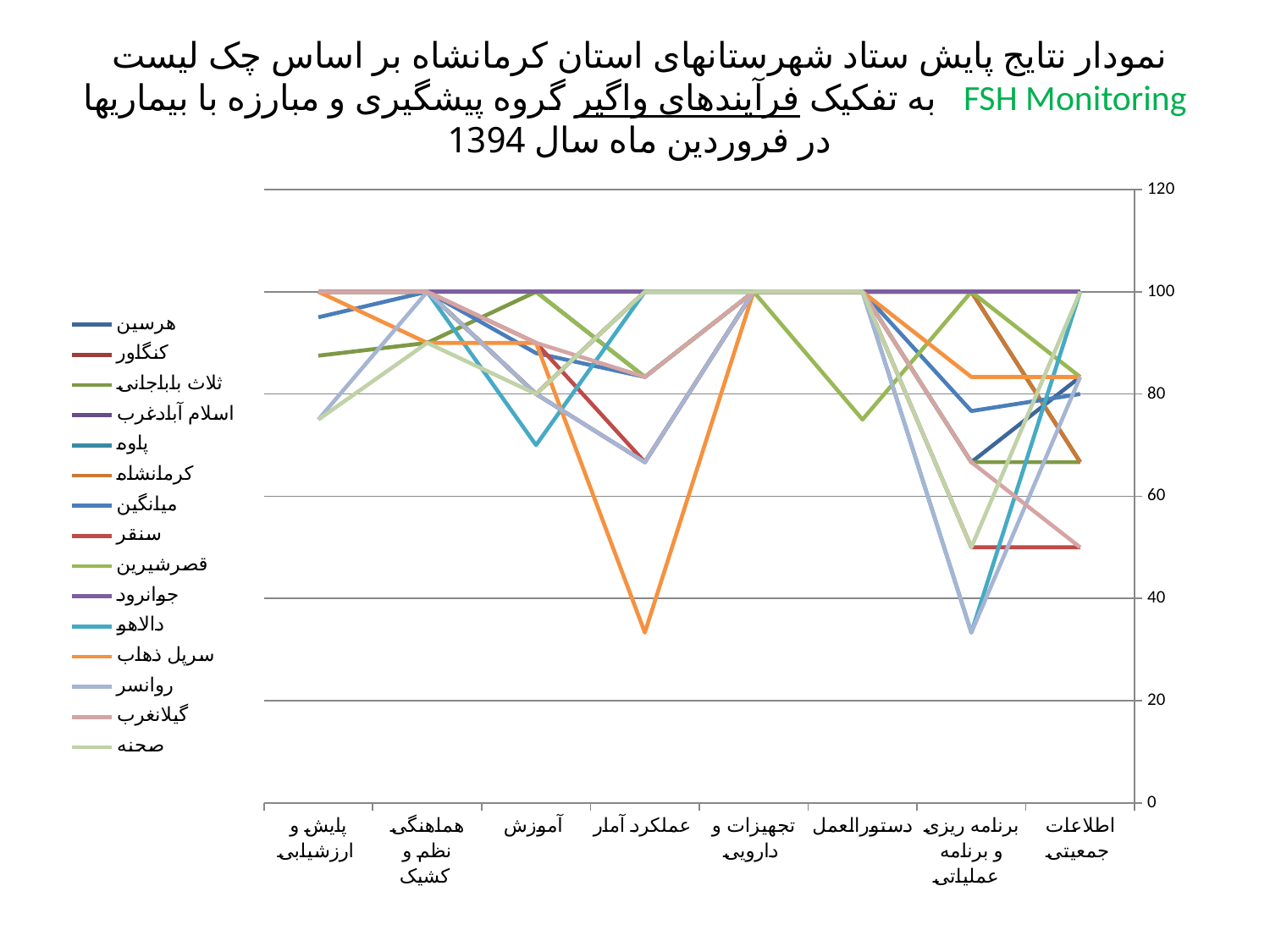
What is the maximum value shown on the y axis? 120 At the category تجهیزات و دارویی, what value do all the series reach? 100 How many categories are shown along the x axis? 8 Which month and year does the chart title say the monitoring results are for? فروردین ماه سال 1394 At the category عملکرد آمار, is the lowest series value greater or less than 40? less Is the lowest plotted value on the chart greater or less than 40? less What value does the flat line running along the top of the chart hold across all categories? 100 How many series does the legend list? 15 What kind of chart is shown on the slide? line chart At the category دستورالعمل, is the lowest series value greater or less than 80? less